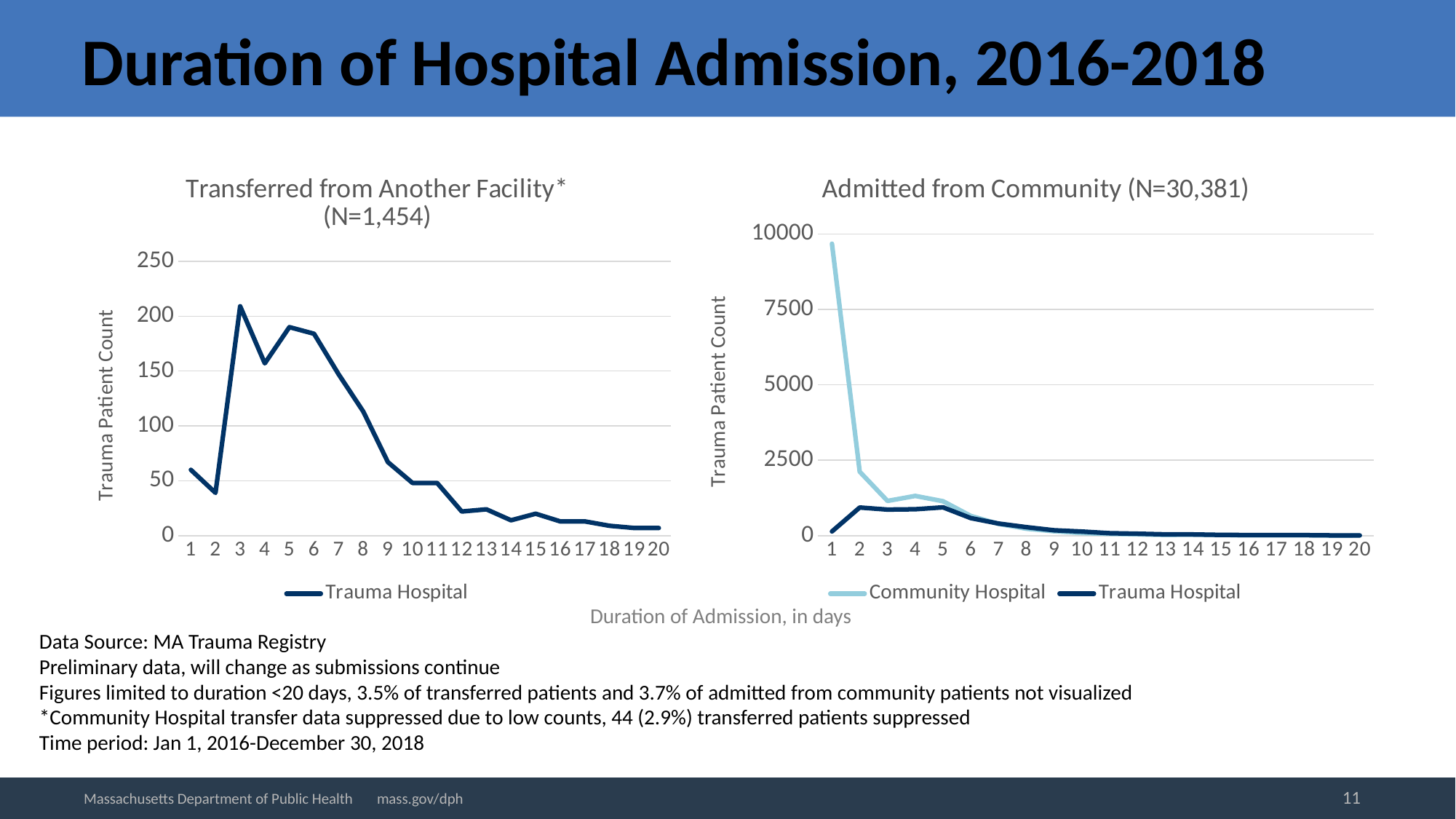
In the "Admitted from Community" chart, which series has the larger value at day 1, Community Hospital or Trauma Hospital? Community Hospital In the "Transferred from Another Facility" chart, at which duration in days is the Trauma Hospital count highest? 3 What kind of chart is the "Transferred from Another Facility" chart? line chart In the "Admitted from Community" chart, is the Community Hospital value at day 2 greater or less than 2500? less How many duration-of-admission points are plotted along the x axis of the "Transferred from Another Facility" chart? 20 How many series does the legend of the "Admitted from Community" chart list? 2 In the "Transferred from Another Facility" chart, is the Trauma Hospital value at day 2 greater or less than 50? less What is the y-axis label of the "Admitted from Community" chart? Trauma Patient Count In the "Transferred from Another Facility" chart, is the Trauma Hospital value at day 3 greater or less than 200? greater In the "Transferred from Another Facility" chart, which is larger, the Trauma Hospital value at day 3 or at day 9? day 3 In the "Admitted from Community" chart, does the Community Hospital line rise or fall from day 1 to day 20? fall